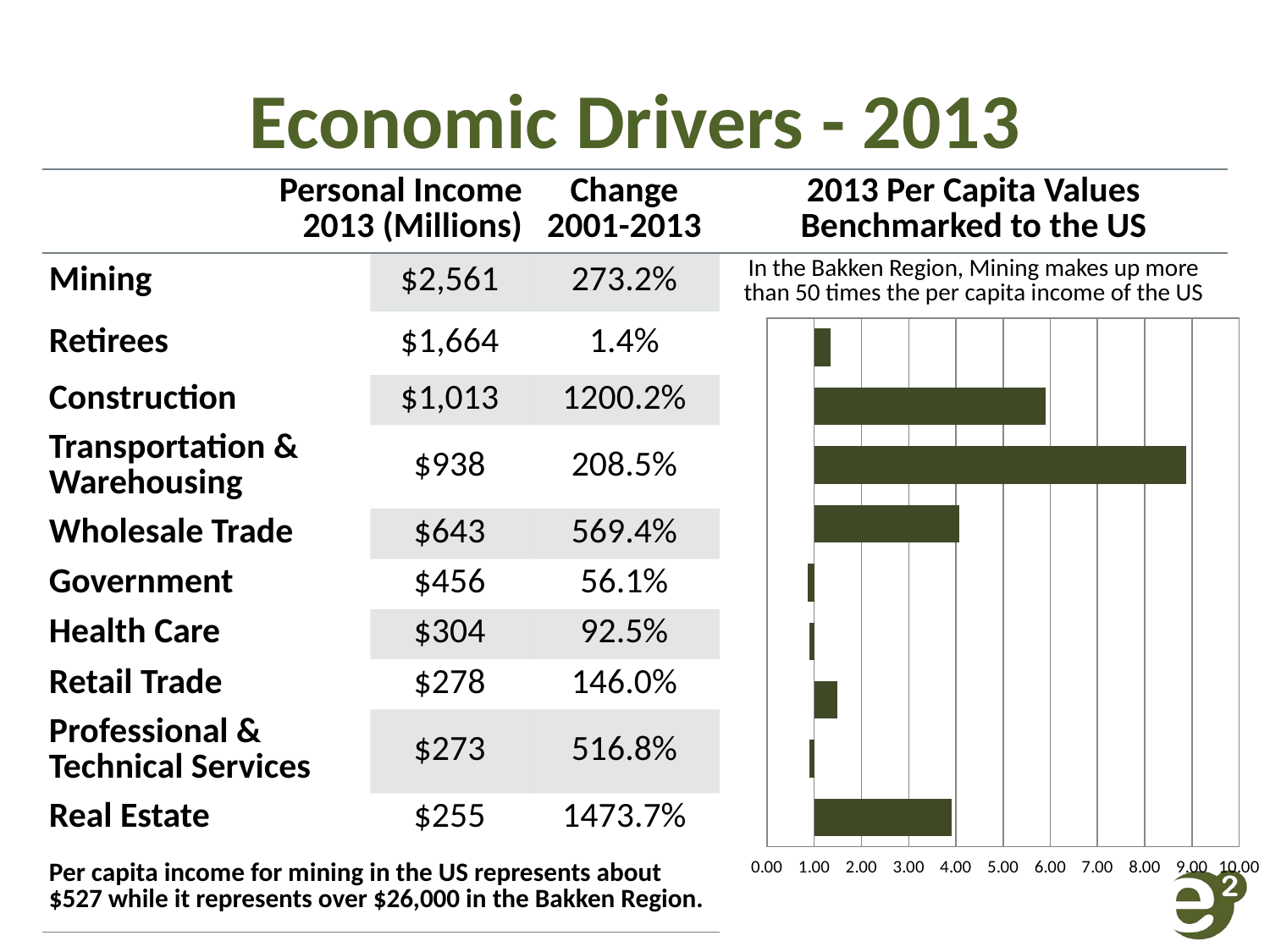
Is the value of the top bar (Retirees) greater or less than 1.00? greater What is the highest value shown on the x axis of the chart? 10.00 Is the value of the third bar from the top (Transportation & Warehousing) greater or less than 8.00? greater Is the value of the second bar from the top (Construction) greater or less than 5.00? greater What is the title of the chart on the right side of the slide? 2013 Per Capita Values Benchmarked to the US What kind of chart is shown on the right side of the slide? bar chart Which is larger in the chart: the bottom bar (Real Estate) or the top bar (Retirees)? Real Estate How many bars are plotted in the chart on the right? 9 Which is larger in the chart: the second bar from the top (Construction) or the fourth bar from the top (Wholesale Trade)? Construction Which bar in the chart is the longest, counting from the top? the third bar (Transportation & Warehousing)